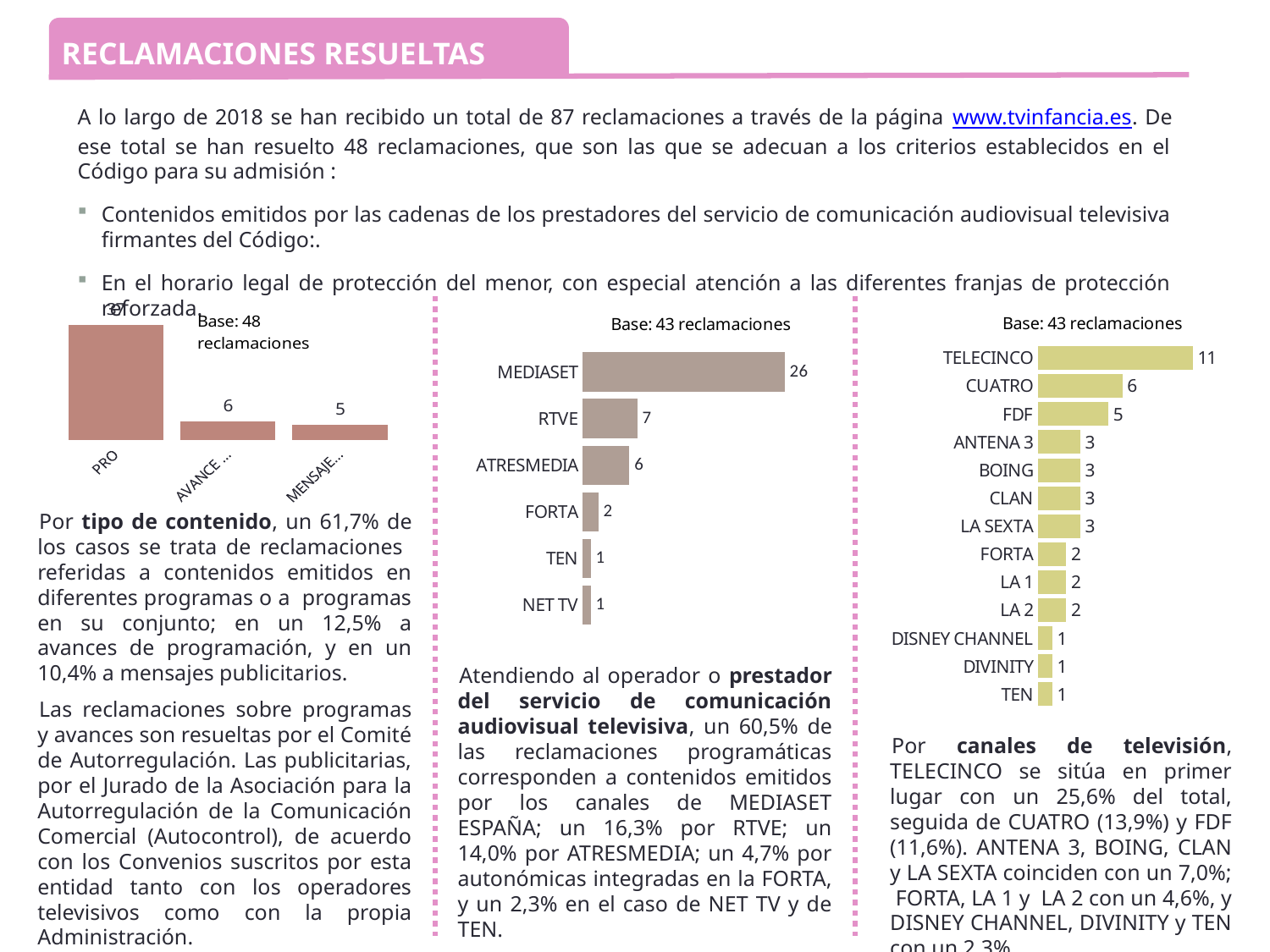
In the right-hand chart, what is the value for FDF? 5 What kind of chart is the right-hand chart? Bar chart In the right-hand chart, what is the value for TELECINCO? 11 In the middle chart, what is the difference between the values for MEDIASET and ATRESMEDIA? 20 In the right-hand chart, which is larger, the value for CUATRO or the value for LA SEXTA? CUATRO In the left-hand chart, what is the value for AVANCE...? 6 In the right-hand chart, how many channels are plotted? 13 In the right-hand chart, which channel has the highest value? TELECINCO In the middle chart, what is the value for RTVE? 7 In the middle chart, which category has the highest value? MEDIASET In the middle chart, how many categories are plotted? 6 In the middle chart, what is the value for MEDIASET? 26